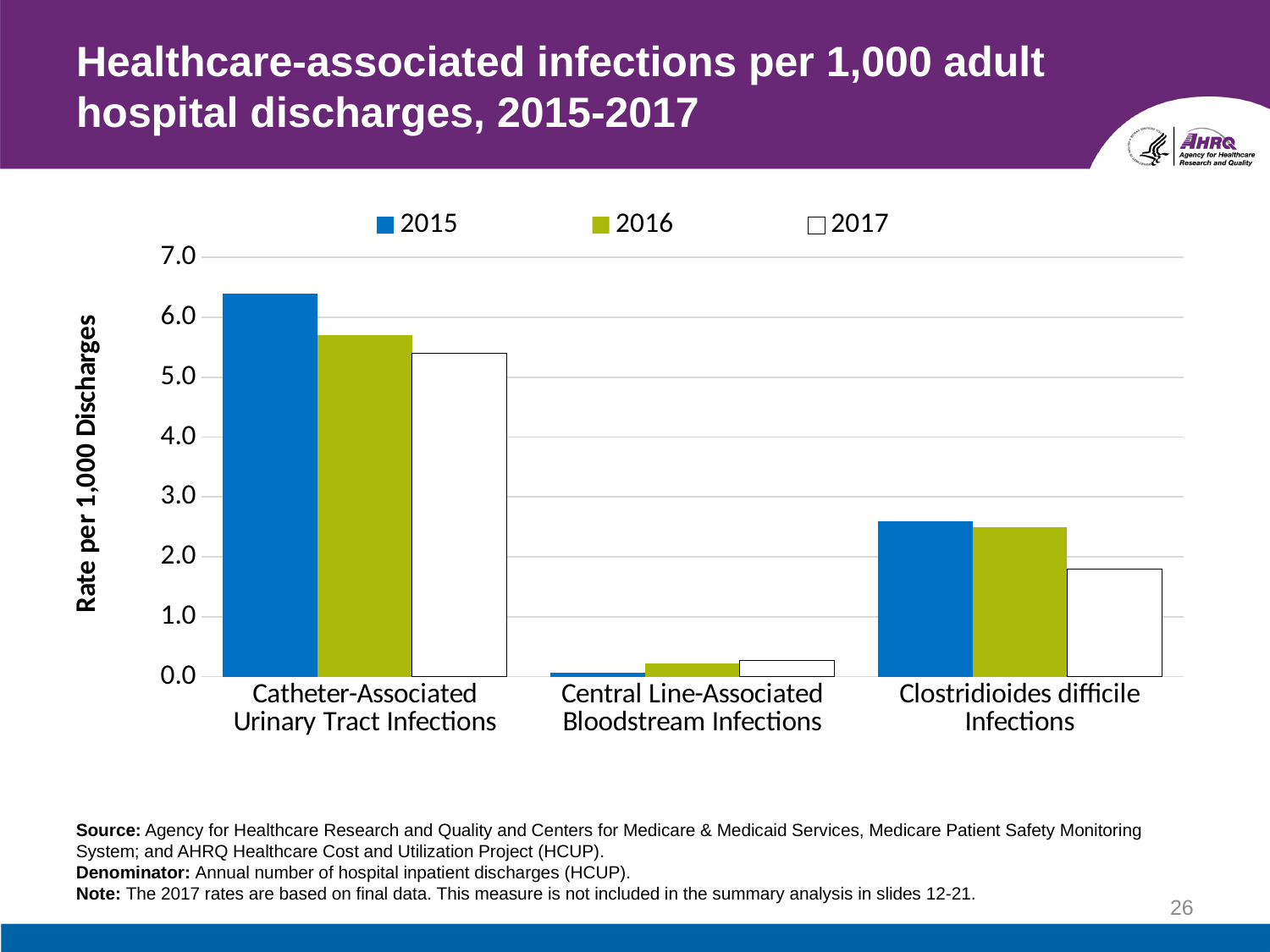
Which infection category has the highest rate in 2015? Catheter-Associated Urinary Tract Infections Is the 2017 value for Clostridioides difficile Infections greater or less than 2.0? less What is the label on the y axis of the chart? Rate per 1,000 Discharges Is the 2015 value for Clostridioides difficile Infections greater or less than 2.0? greater How many series does the legend list? 3 Is the 2017 value for Catheter-Associated Urinary Tract Infections greater or less than 6.0? less Which infection category has the lowest rate in 2017? Central Line-Associated Bloodstream Infections For Catheter-Associated Urinary Tract Infections, do the values rise or fall from 2015 to 2017? fall How many infection categories are shown on the x axis? 3 Which is larger for Clostridioides difficile Infections: the 2015 value or the 2017 value? 2015 What kind of chart is shown on the slide? bar chart